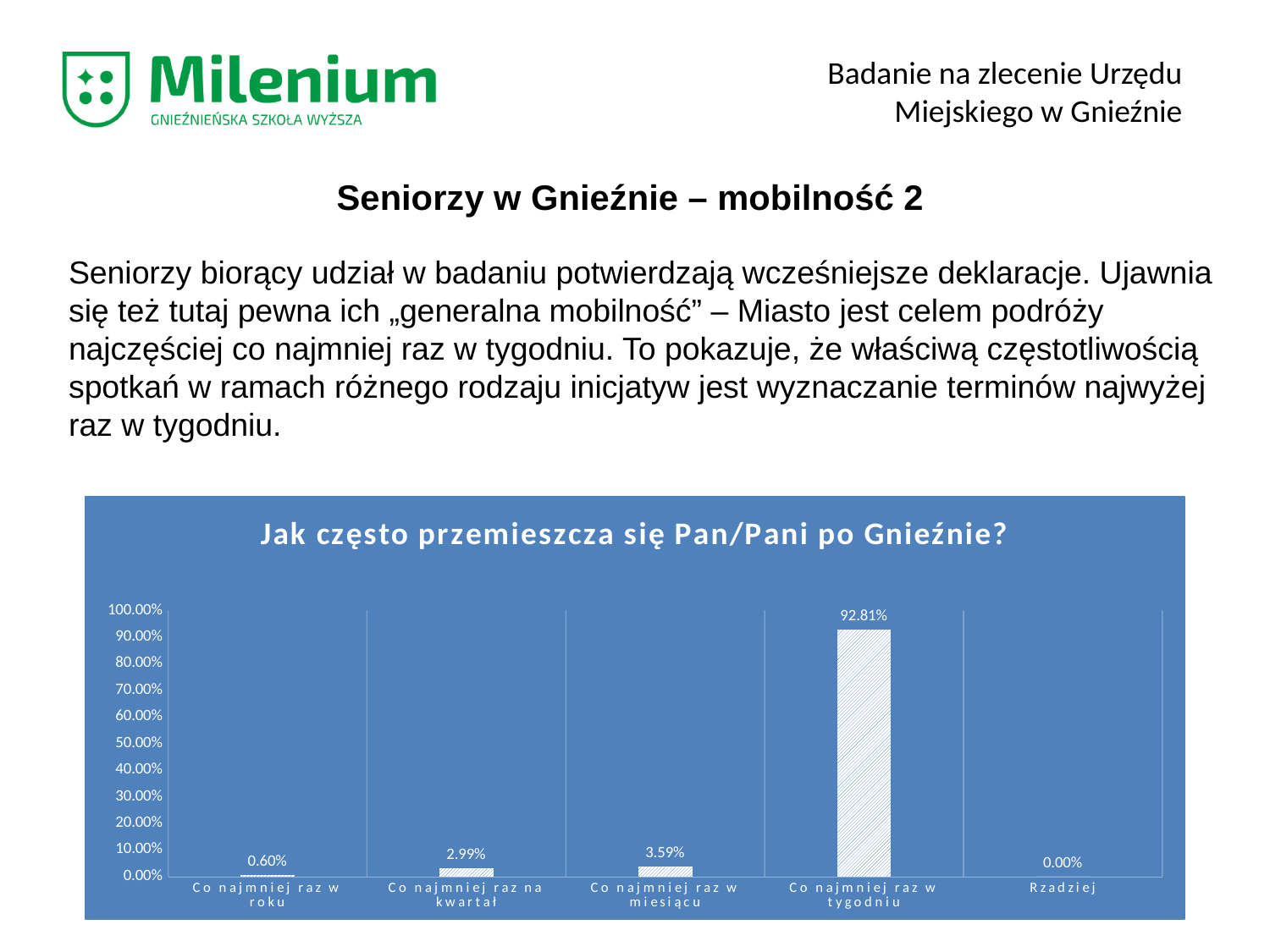
Which category has the lowest value? Rzadziej Which is larger: "Co najmniej raz na kwartał" or "Co najmniej raz w miesiącu"? Co najmniej raz w miesiącu Which category has the highest value? Co najmniej raz w tygodniu What is the value for "Co najmniej raz w roku"? 0.60% What is the value for "Rzadziej"? 0.00% What is the value for "Co najmniej raz w miesiącu"? 3.59% What is the title of the chart? Jak często przemieszcza się Pan/Pani po Gnieźnie? How many categories are shown on the x axis? 5 Is the value for "Co najmniej raz w tygodniu" greater or less than 90.00%? greater What is the difference between "Co najmniej raz w tygodniu" and "Co najmniej raz w miesiącu"? 89.22% What is the value for "Co najmniej raz na kwartał"? 2.99% What is the value for "Co najmniej raz w tygodniu"? 92.81%